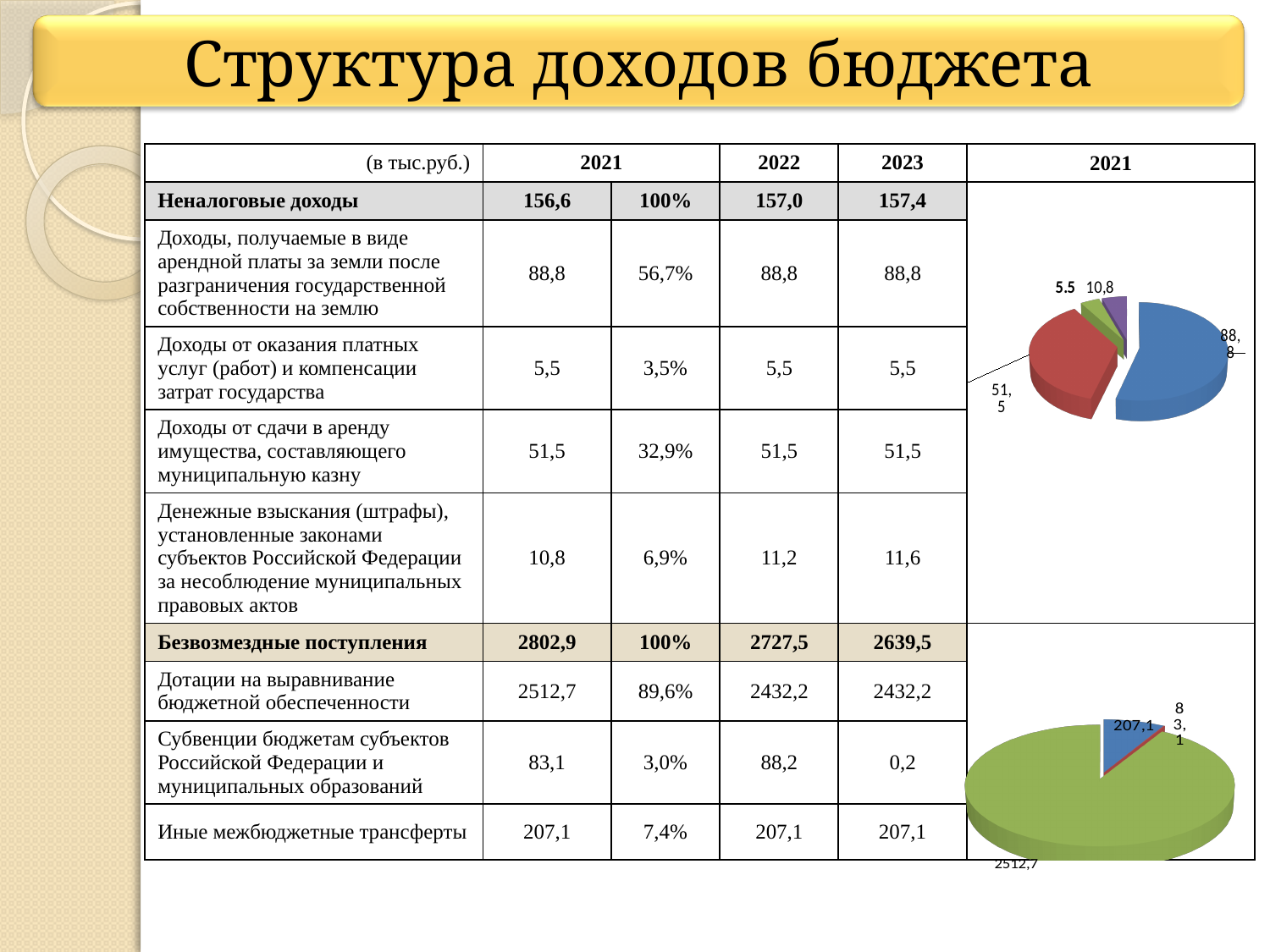
In the top pie chart, what is the difference between the 88,8 slice and the 51,5 slice? 37,3 In the bottom pie chart, which slice is larger: the one labelled 207,1 or the one labelled 83,1? 207,1 In the bottom pie chart, what is the value of the largest slice? 2512,7 What kind of chart is the top chart on the right side of the slide? Pie chart In the top pie chart, what is the value of the smallest slice? 5.5 In the top pie chart, what is the value of the blue slice? 88,8 How many slices does the bottom pie chart have? 3 In the top pie chart, what is the value of the largest slice? 88,8 How many slices does the top pie chart have? 4 In the bottom pie chart, what is the value of the smallest slice? 83,1 In the bottom pie chart, what is the difference between the 2512,7 slice and the 207,1 slice? 2305,6 In the bottom pie chart, what colour is the largest slice? Green